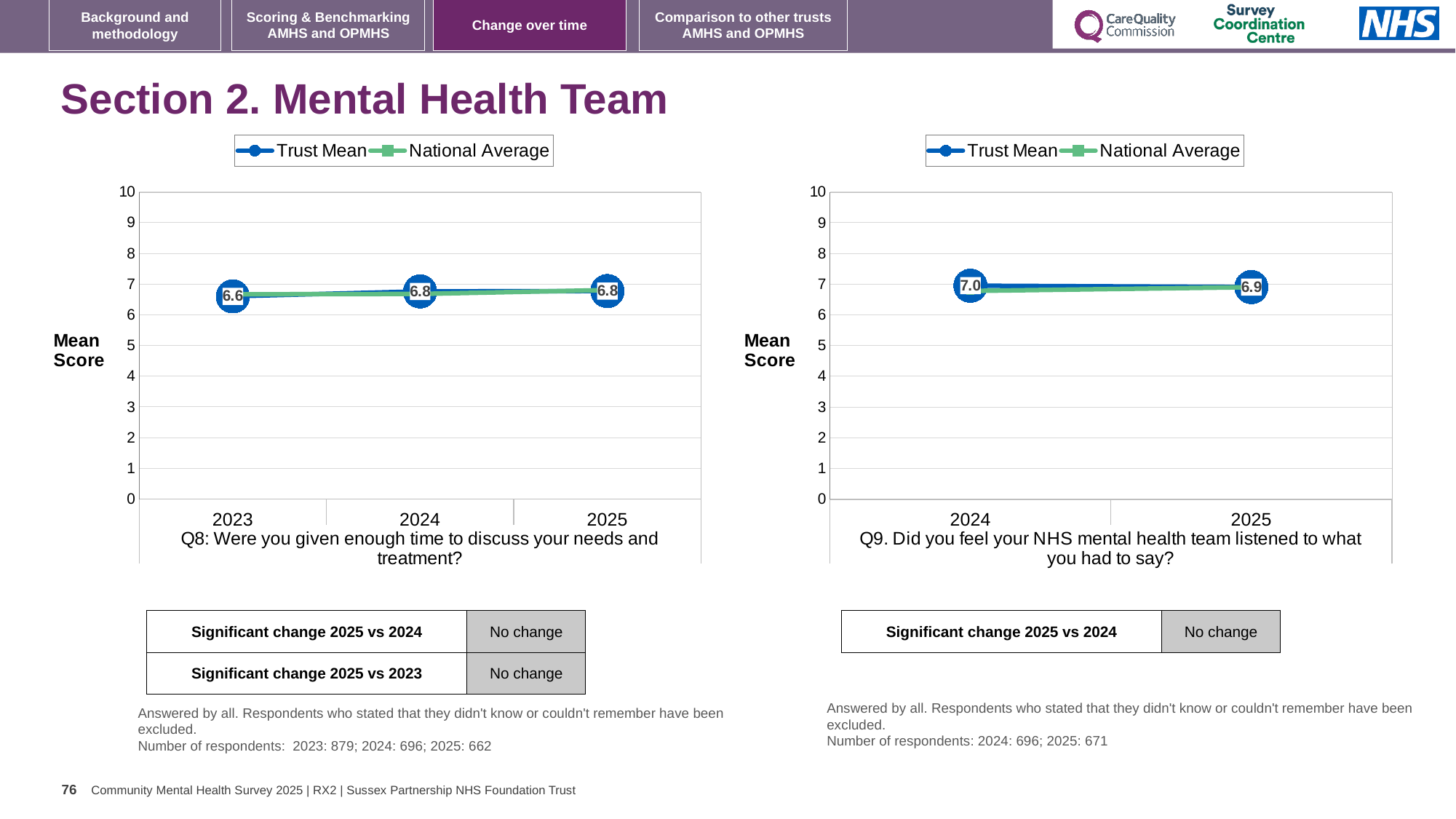
What kind of chart is the Q8 chart on the left? Line chart On the Q9 chart (right), what is the Trust Mean score for 2025? 6.9 On the Q9 chart (right), what is the difference between the Trust Mean scores for 2024 and 2025? 0.1 On the Q9 chart (right), how many series does the legend list? 2 On the Q8 chart (left), how many years are plotted on the x axis? 3 On the Q9 chart (right), what is the Trust Mean score for 2024? 7.0 On the Q8 chart (left), is the Trust Mean score for 2023 greater or less than 7? less On the Q8 chart (left), what is the difference between the Trust Mean scores for 2024 and 2023? 0.2 On the Q8 chart (left), what is the Trust Mean score for 2023? 6.6 On the Q8 chart (left), which year has the lowest Trust Mean score? 2023 On the Q9 chart (right), how many years are plotted on the x axis? 2 On the Q8 chart (left), what is the Trust Mean score for 2025? 6.8